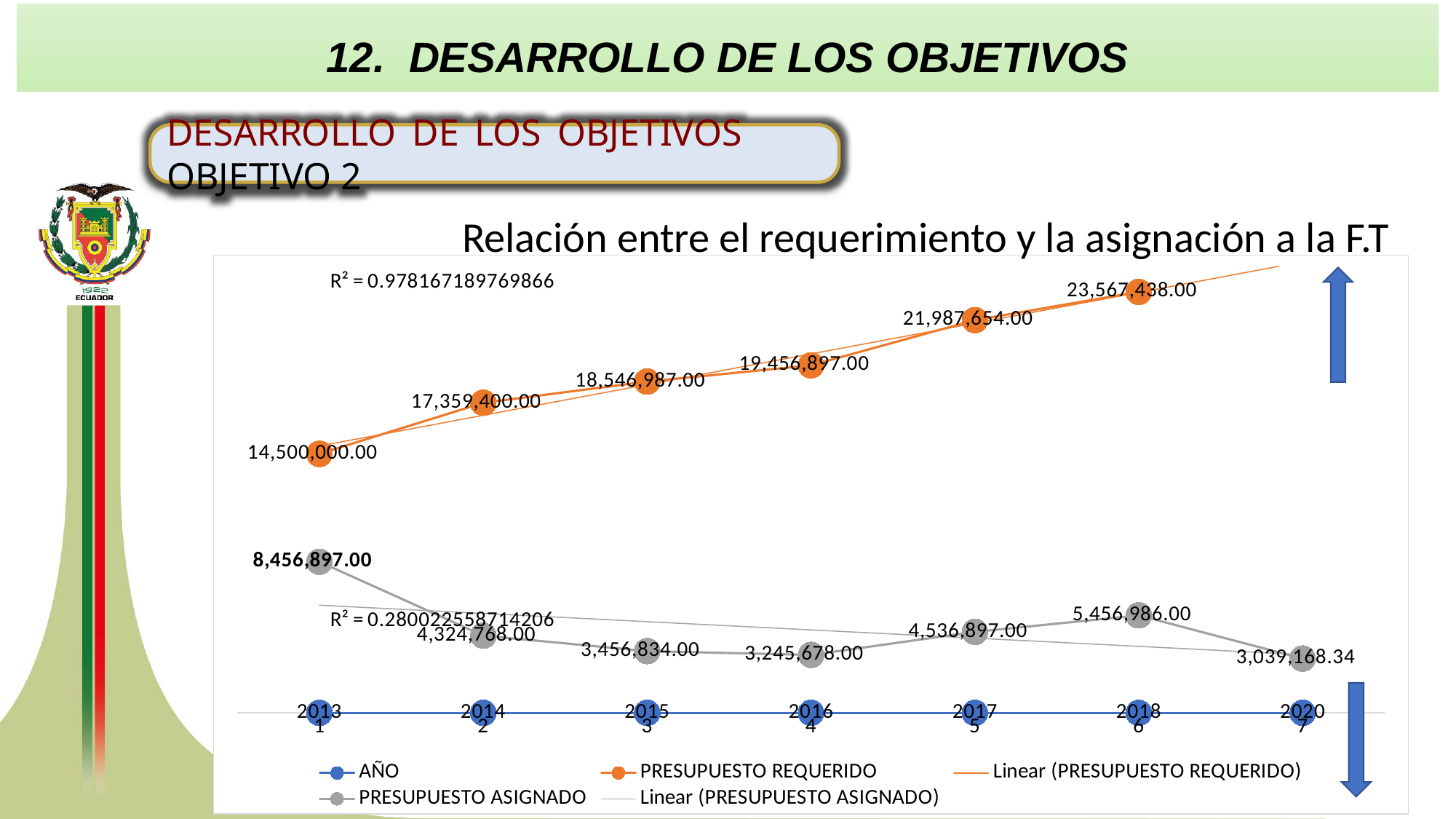
How many entries does the chart legend list? 5 What is the PRESUPUESTO ASIGNADO value for 2018? 5,456,986.00 What is the difference between PRESUPUESTO REQUERIDO and PRESUPUESTO ASIGNADO in 2016? 16,211,219.00 In which year is PRESUPUESTO ASIGNADO highest? 2013 What is the difference between PRESUPUESTO REQUERIDO in 2018 and in 2013? 9,067,438.00 In which year is PRESUPUESTO ASIGNADO lowest? 2020 What is the PRESUPUESTO REQUERIDO value for 2013? 14,500,000.00 Which year has the larger PRESUPUESTO ASIGNADO, 2014 or 2017? 2017 What R² value is shown for the PRESUPUESTO REQUERIDO trendline? 0.978167189769866 Does PRESUPUESTO REQUERIDO rise or fall from 2013 to 2018? Rise What is the PRESUPUESTO ASIGNADO value for 2016? 3,245,678.00 What kind of chart is shown on the slide? Line chart